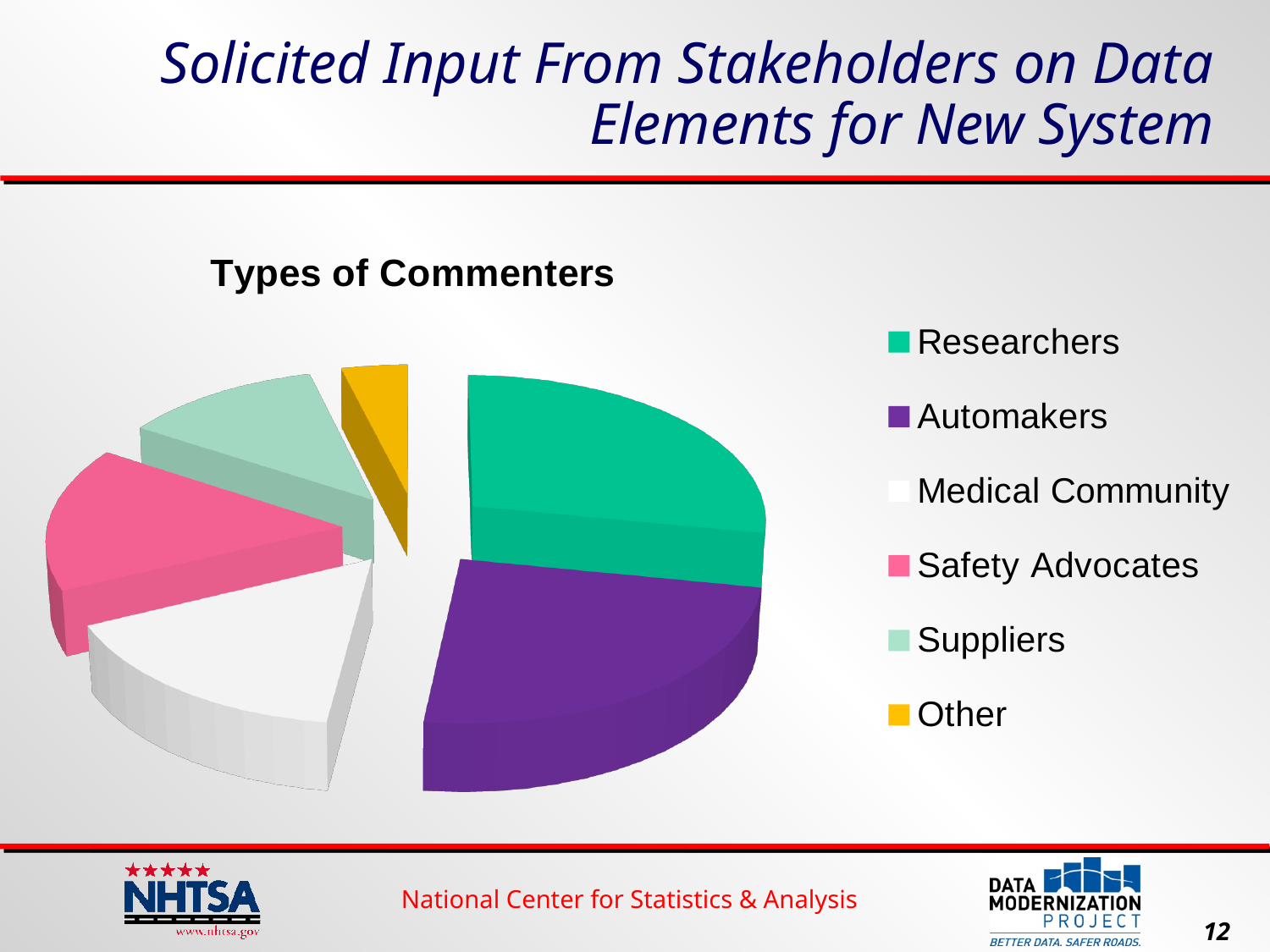
What kind of chart is shown on the slide? Pie chart How many slices does the pie chart have? 6 How many categories does the legend of the pie chart list? 6 Which slice is larger, Automakers or Safety Advocates? Automakers Which colour represents Other in the pie chart? Yellow Which legend entry is listed first in the pie chart's legend? Researchers Which slice is larger, Medical Community or Other? Medical Community What is the title of the chart? Types of Commenters Which slice is larger, Researchers or Other? Researchers Which category has the smallest slice in the pie chart? Other